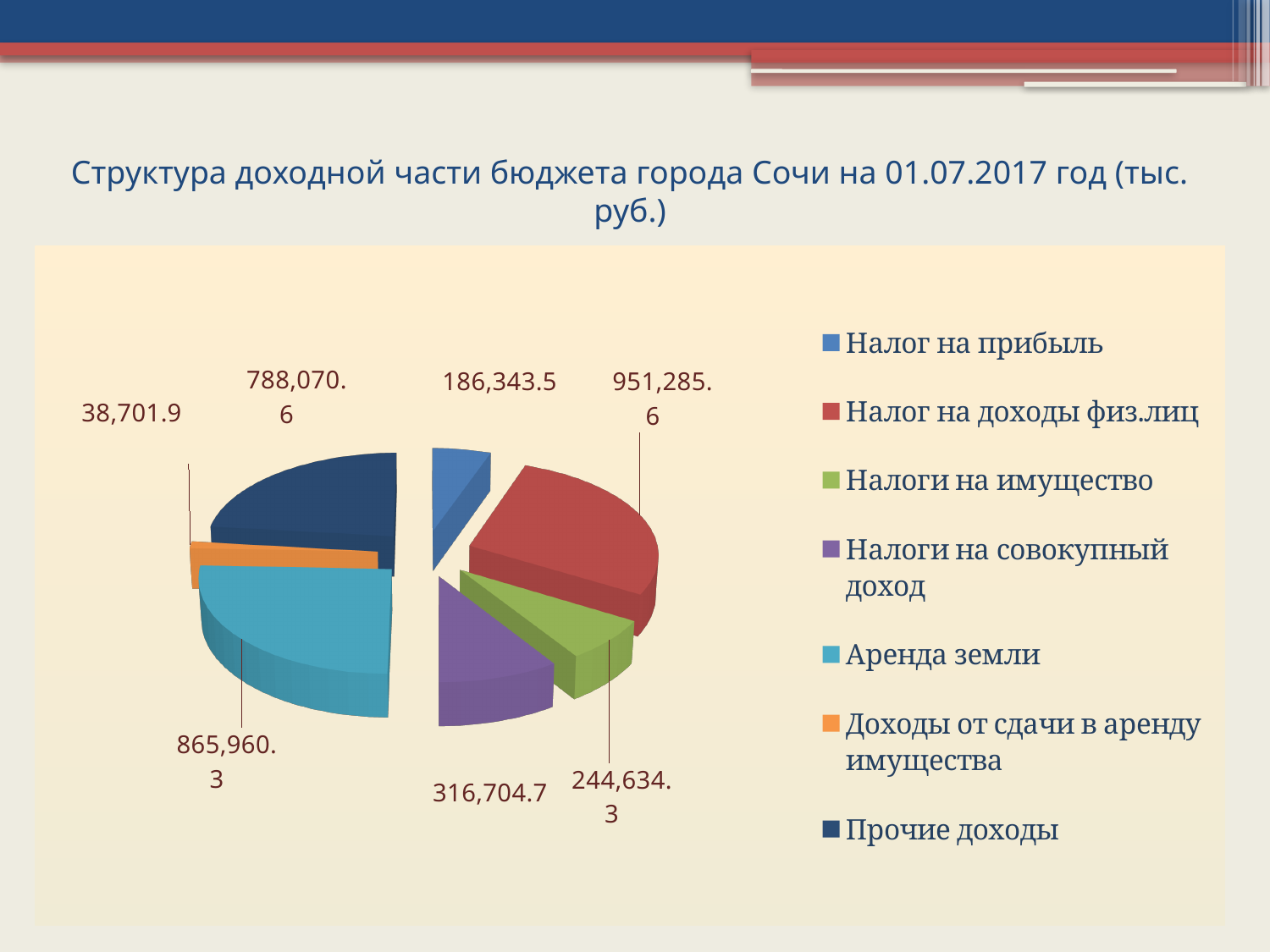
Which category has the largest value? Налог на доходы физ.лиц What is the value for Налоги на совокупный доход? 316,704.7 What is the difference between Налог на доходы физ.лиц and Аренда земли? 85,325.3 What is the value for Налог на доходы физ.лиц? 951,285.6 Which category has the smallest value? Доходы от сдачи в аренду имущества Which is larger, Прочие доходы or Налог на прибыль? Прочие доходы What is the value for Доходы от сдачи в аренду имущества? 38,701.9 What is the value for Аренда земли? 865,960.3 What kind of chart is shown on the slide? Pie chart How many categories does the pie chart have? 7 What colour is the slice for Аренда земли? Light blue (cyan) What is the difference between Налоги на совокупный доход and Налоги на имущество? 72,070.4